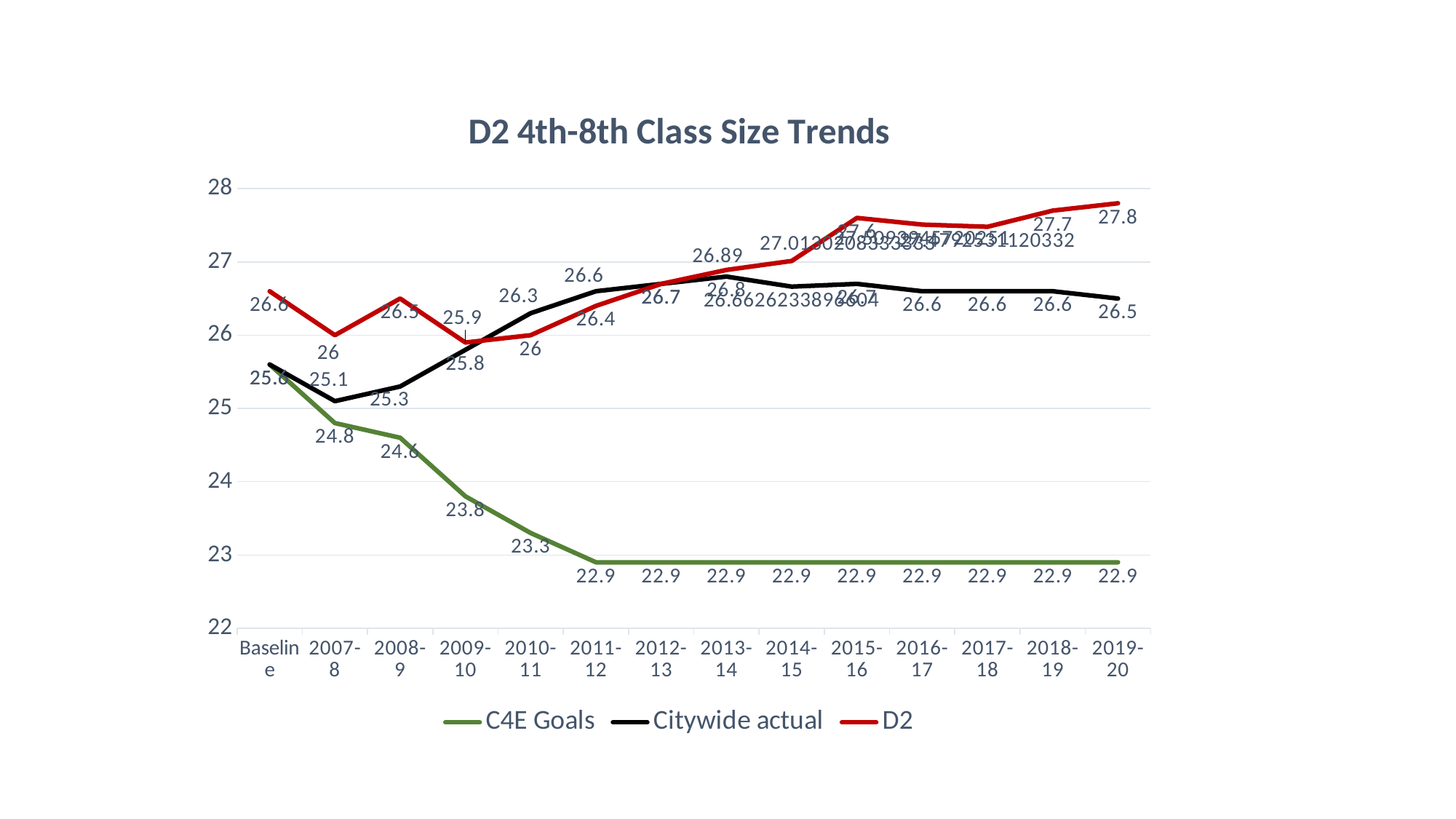
In which year does the Citywide actual series reach its lowest value? 2007-8 Which is larger in 2009-10, the C4E Goals value or the Citywide actual value? Citywide actual How many categories are shown along the x axis? 14 What kind of chart is shown on the slide? line chart How many series does the legend list? 3 What is the title of the chart? D2 4th-8th Class Size Trends What is the D2 value for 2019-20? 27.8 What is the difference between the D2 value and the Citywide actual value in 2019-20? 1.3 In which year does the D2 series reach its highest value? 2019-20 Do the C4E Goals values rise or fall from Baseline to 2011-12? fall What is the C4E Goals value for 2010-11? 23.3 What is the Citywide actual value for 2008-9? 25.3